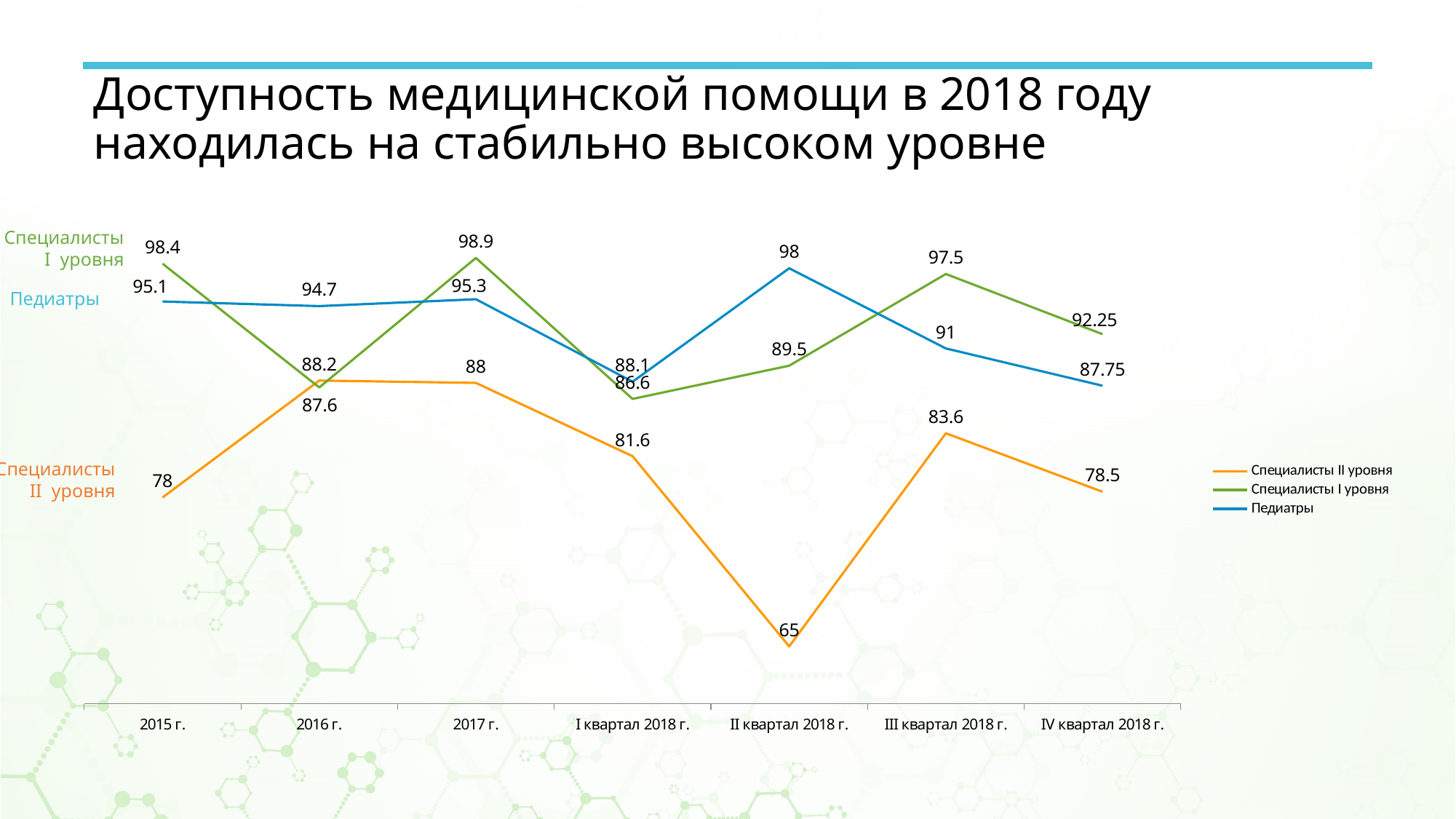
What is the value for Специалисты I уровня in IV квартал 2018 г.? 92.25 In which category does Специалисты I уровня reach its highest value? 2017 г. In which category does Специалисты II уровня have its lowest value? II квартал 2018 г. Does the value for Специалисты II уровня rise or fall from III квартал 2018 г. to IV квартал 2018 г.? fall What type of chart is shown on the slide? line chart How many categories are shown on the x axis? 7 What is the value for Педиатры in II квартал 2018 г.? 98 Which is larger in III квартал 2018 г.: Специалисты I уровня or Педиатры? Специалисты I уровня Which colour is used for the Педиатры series? blue What is the value for Специалисты II уровня in II квартал 2018 г.? 65 What is the difference between the Педиатры values in II квартал 2018 г. and IV квартал 2018 г.? 10.25 How many series does the legend list? 3